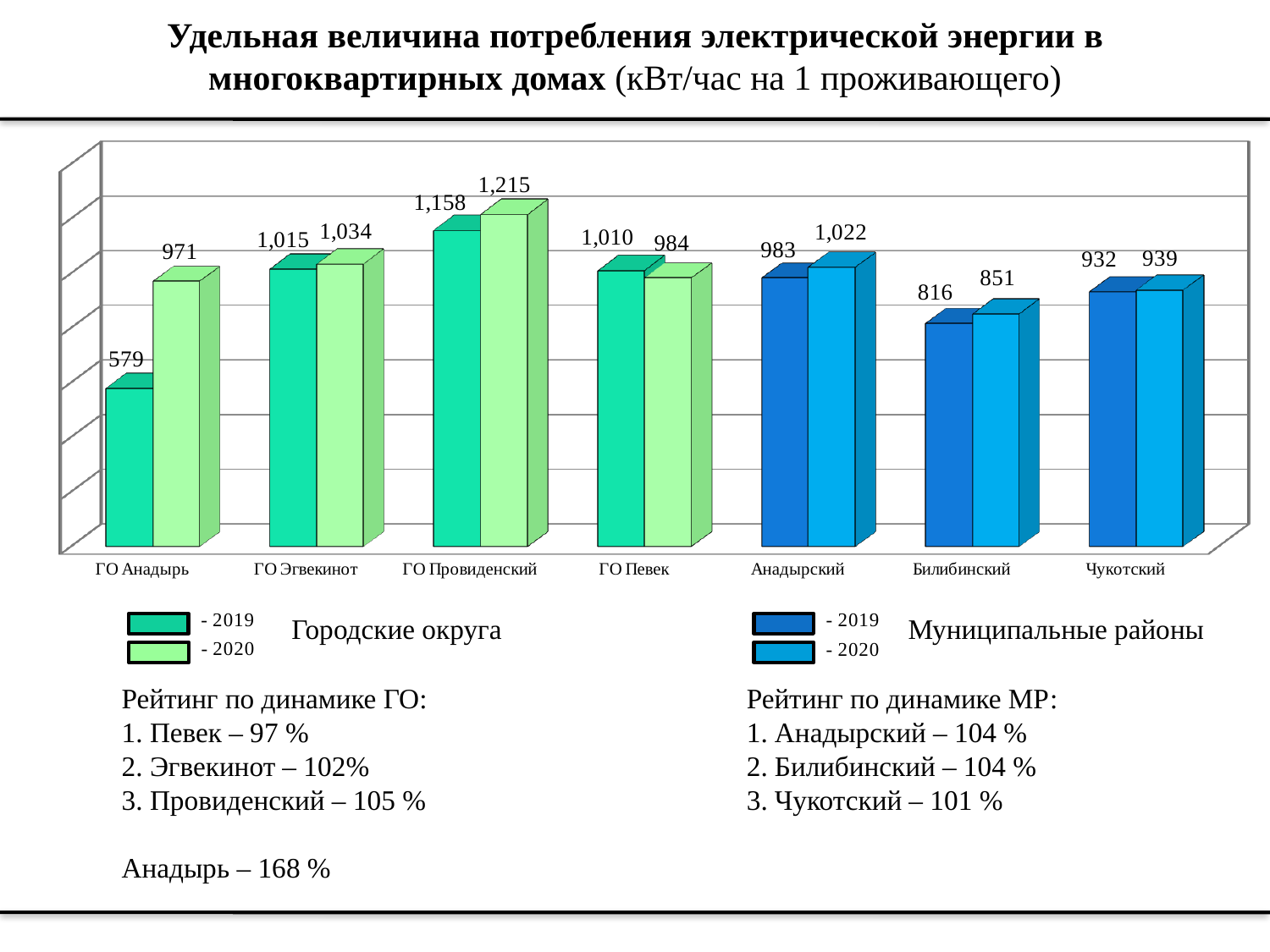
What is the 2020 value for ГО Провиденский? 1,215 Which category has the highest 2020 value? ГО Провиденский What kind of chart is shown on the slide? bar chart What is the difference between the 2020 and 2019 values for ГО Провиденский? 57 For ГО Певек, which is larger: the 2019 value or the 2020 value? 2019 Which category has the lowest 2019 value? ГО Анадырь What is the 2019 value for Чукотский? 932 How many categories are shown on the x axis of the chart? 7 How many series (years) does the legend list for each group? 2 What is the 2020 value for Билибинский? 851 What is the 2019 value for ГО Анадырь? 579 What is the difference between the 2020 and 2019 values for ГО Анадырь? 392